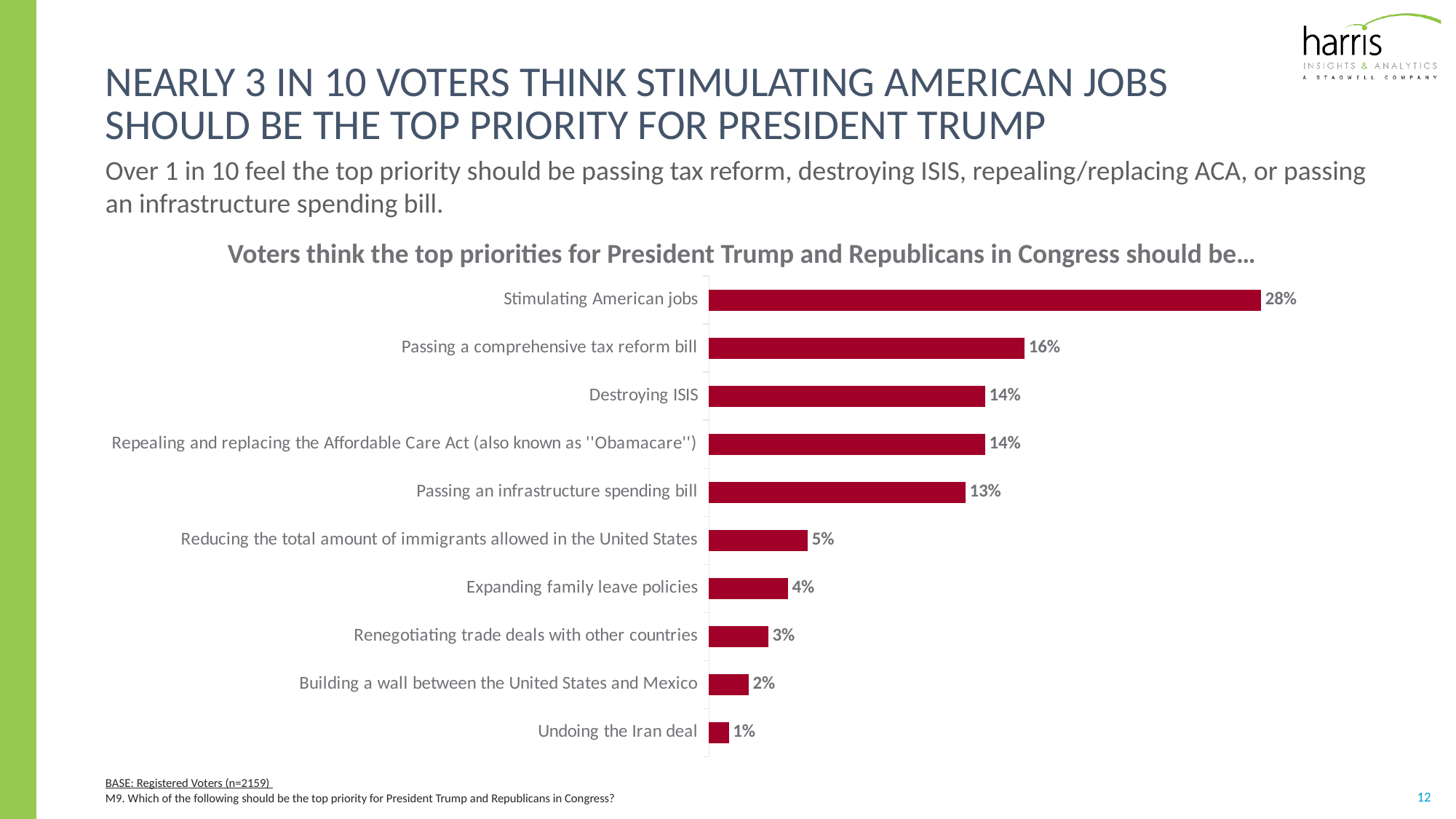
What is the value for Passing an infrastructure spending bill? 13% What is the difference between the values for Reducing the total amount of immigrants allowed in the United States and Expanding family leave policies? 1% What is the title of the chart? Voters think the top priorities for President Trump and Republicans in Congress should be… What percentage of voters think stimulating American jobs should be the top priority? 28% What is the difference between the values for Stimulating American jobs and Passing a comprehensive tax reform bill? 12% Which priority has the lowest value? Undoing the Iran deal Which priority has the highest value? Stimulating American jobs What kind of chart is shown on the slide? Bar chart Which is larger: the value for Destroying ISIS or the value for Passing an infrastructure spending bill? Destroying ISIS How many priorities are shown in the chart? 10 What is the value for Passing a comprehensive tax reform bill? 16% What is the value for Building a wall between the United States and Mexico? 2%